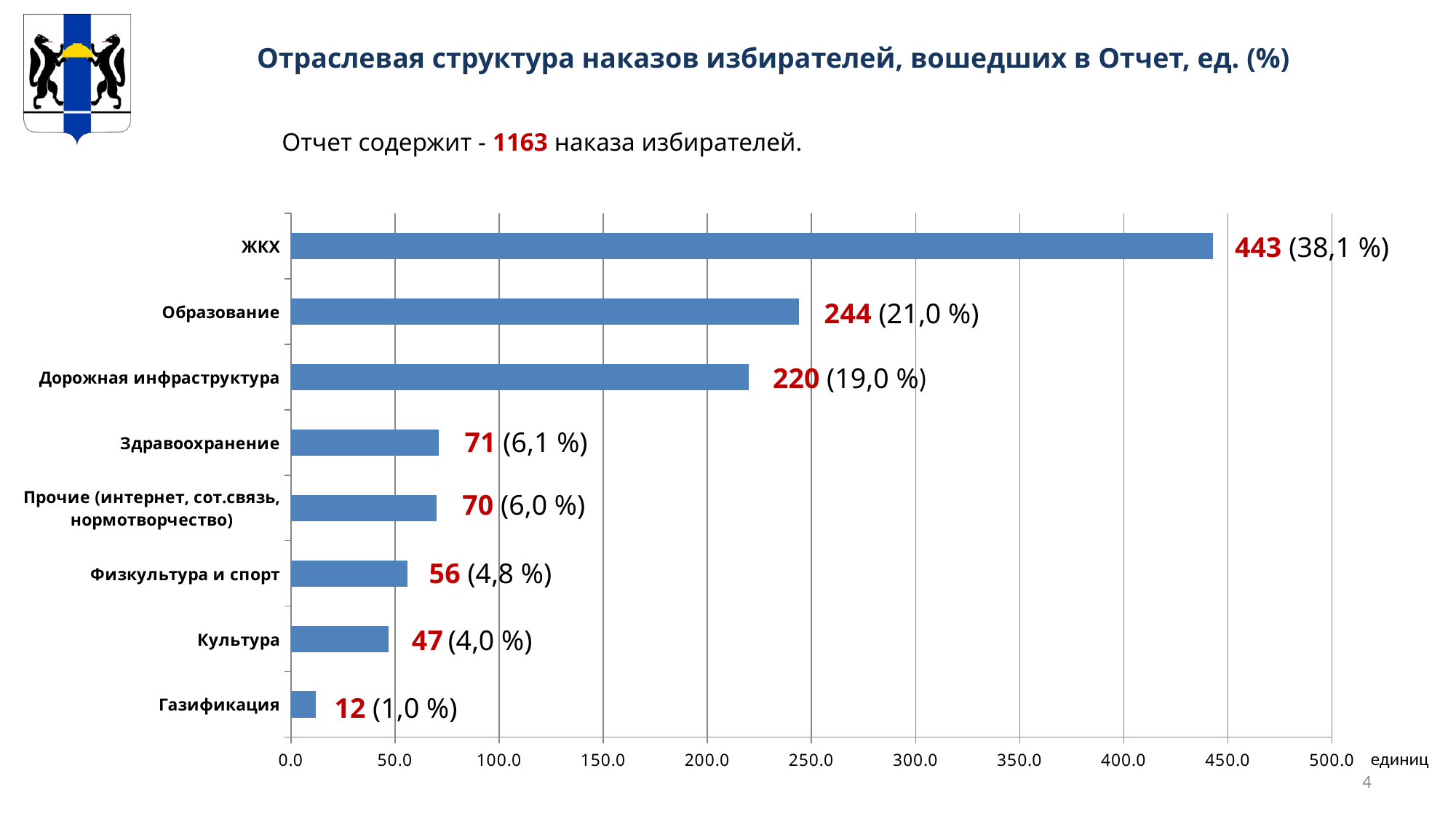
What is the difference between the values for ЖКХ and Образование? 199 Is the value for Здравоохранение greater or less than 50? greater What kind of chart is shown on the slide? bar chart What percentage is shown for ЖКХ? 38,1 % How many categories are shown in the chart? 8 Which category has the highest value in the chart? ЖКХ Which is larger, the value for Образование or the value for Дорожная инфраструктура? Образование What is the value for Образование? 244 What is the value for Физкультура и спорт? 56 What percentage is shown for Дорожная инфраструктура? 19,0 % Which category has the lowest value in the chart? Газификация What is the title of the chart on the slide? Отраслевая структура наказов избирателей, вошедших в Отчет, ед. (%)